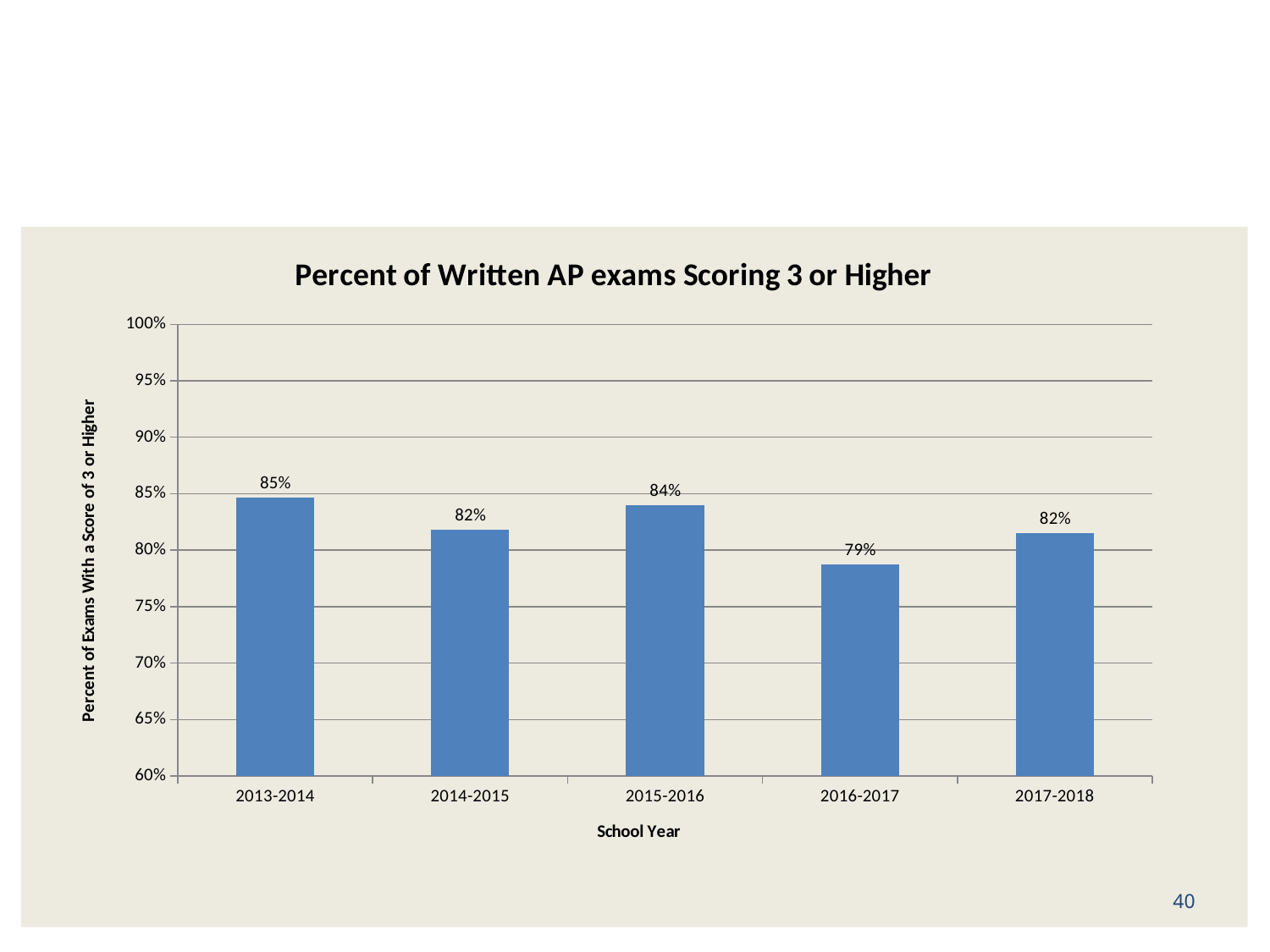
What percent of written AP exams scored 3 or higher in 2016-2017? 79% What percent of written AP exams scored 3 or higher in 2013-2014? 85% How many school years are shown on the chart? 5 Which is larger, the value for 2015-2016 or the value for 2016-2017? 2015-2016 What is the title of the chart? Percent of Written AP exams Scoring 3 or Higher What kind of chart is shown on the slide? bar chart What is the difference between the 2013-2014 value and the 2016-2017 value? 6% Which school year has the highest percent of written AP exams scoring 3 or higher? 2013-2014 What is the label of the x axis? School Year Which school year has the lowest percent of written AP exams scoring 3 or higher? 2016-2017 What is the value shown for the 2015-2016 school year? 84% Is the value for 2016-2017 greater or less than 80%? less